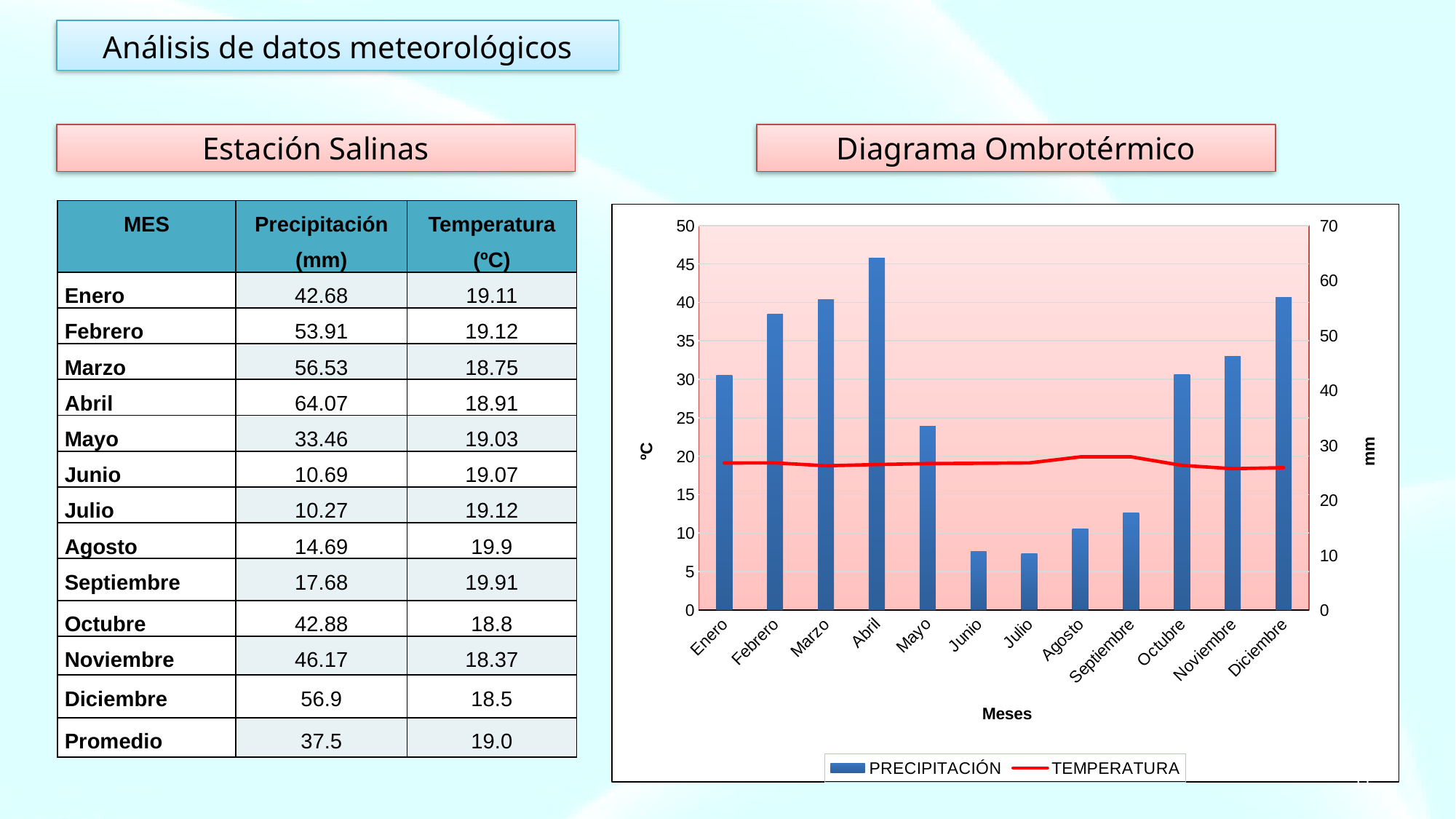
Is the precipitation bar for Abril greater or less than 60 mm on the right axis of the Diagrama Ombrotérmico? greater How many series does the legend of the Diagrama Ombrotérmico list? 2 In the Diagrama Ombrotérmico, is the precipitation bar for Febrero taller than the bar for Mayo? Yes, Febrero Using the table values, what is the difference in precipitation between Abril and Julio? 53.8 What type of chart is the Diagrama Ombrotérmico? Combination bar and line chart Which month has the lowest precipitation bar in the Diagrama Ombrotérmico? Julio According to the Estación Salinas table, what is the temperature for Septiembre? 19.91 How many months are plotted along the x axis of the Diagrama Ombrotérmico? 12 In the Diagrama Ombrotérmico, do the precipitation bars rise or fall from Abril to Julio? Fall Is the precipitation bar for Junio greater or less than 20 mm on the right axis of the Diagrama Ombrotérmico? less According to the Estación Salinas table, what is the precipitation for Abril? 64.07 Which month has the highest precipitation bar in the Diagrama Ombrotérmico? Abril